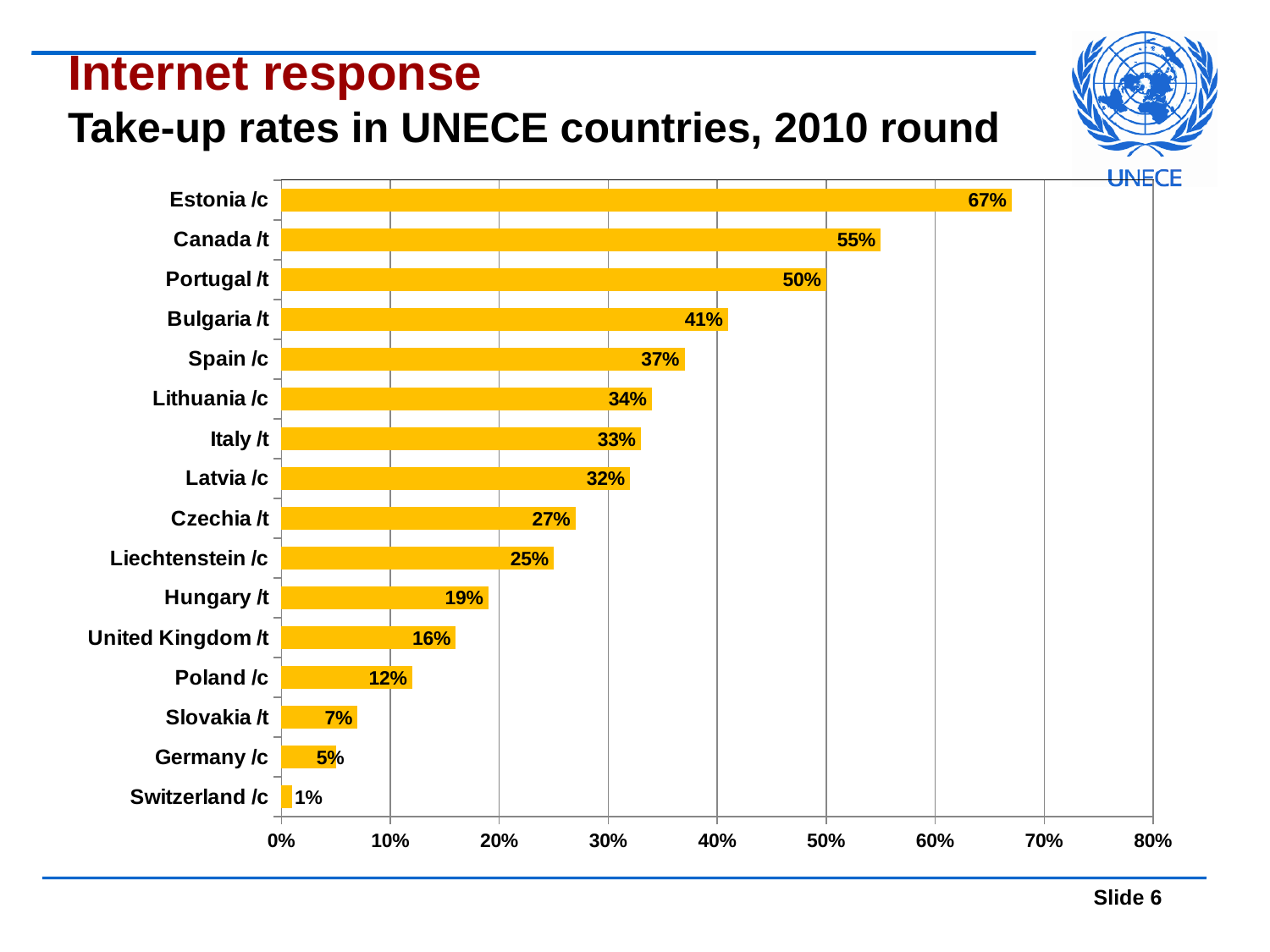
What is the take-up rate for Estonia /c? 67% Which country has the highest take-up rate? Estonia /c Which country has the lowest take-up rate? Switzerland /c What is the difference between the take-up rates of Canada /t and Portugal /t? 5% What is the highest value shown on the horizontal axis? 80% What is the difference between the take-up rates of Estonia /c and Germany /c? 62% How many countries are shown in the chart? 16 What type of chart is shown on the slide? Bar chart What is the take-up rate for Czechia /t? 27% Which has a higher take-up rate, Hungary /t or Poland /c? Hungary /t Which has a higher take-up rate, Bulgaria /t or Spain /c? Bulgaria /t What is the take-up rate for United Kingdom /t? 16%